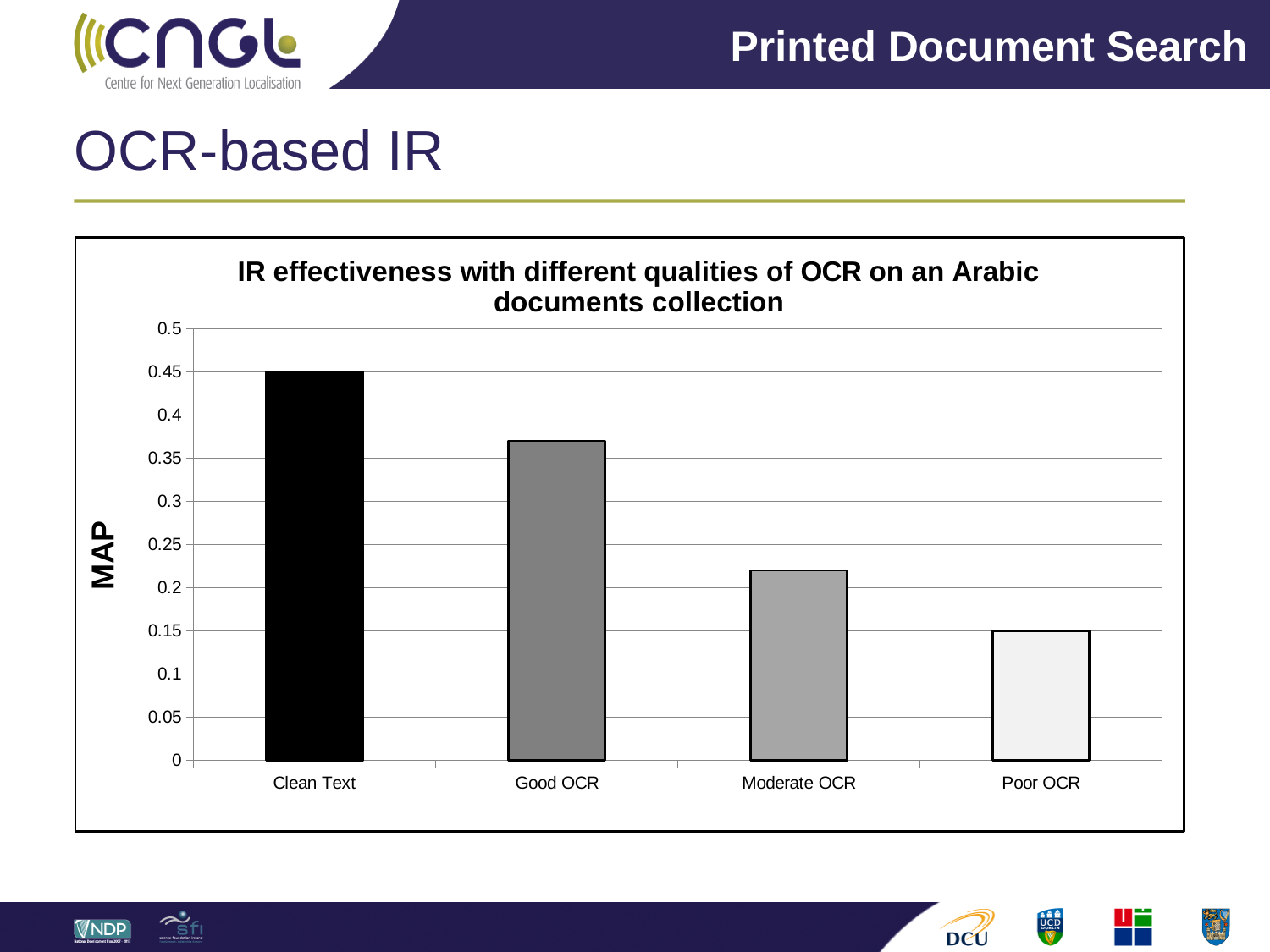
Which has a higher MAP, Good OCR or Moderate OCR? Good OCR Which category has the highest MAP? Clean Text Is the MAP value for Good OCR greater or less than 0.35? greater Is the MAP value for Moderate OCR greater or less than 0.25? less How many categories are shown on the x axis? 4 Do the MAP values rise or fall from Clean Text to Poor OCR along the x axis? fall What is the MAP value for Poor OCR? 0.15 What is the title of the chart? IR effectiveness with different qualities of OCR on an Arabic documents collection Which category has the lowest MAP? Poor OCR What is the MAP value for Clean Text? 0.45 What kind of chart is shown on the slide? bar chart What is the label of the vertical axis? MAP